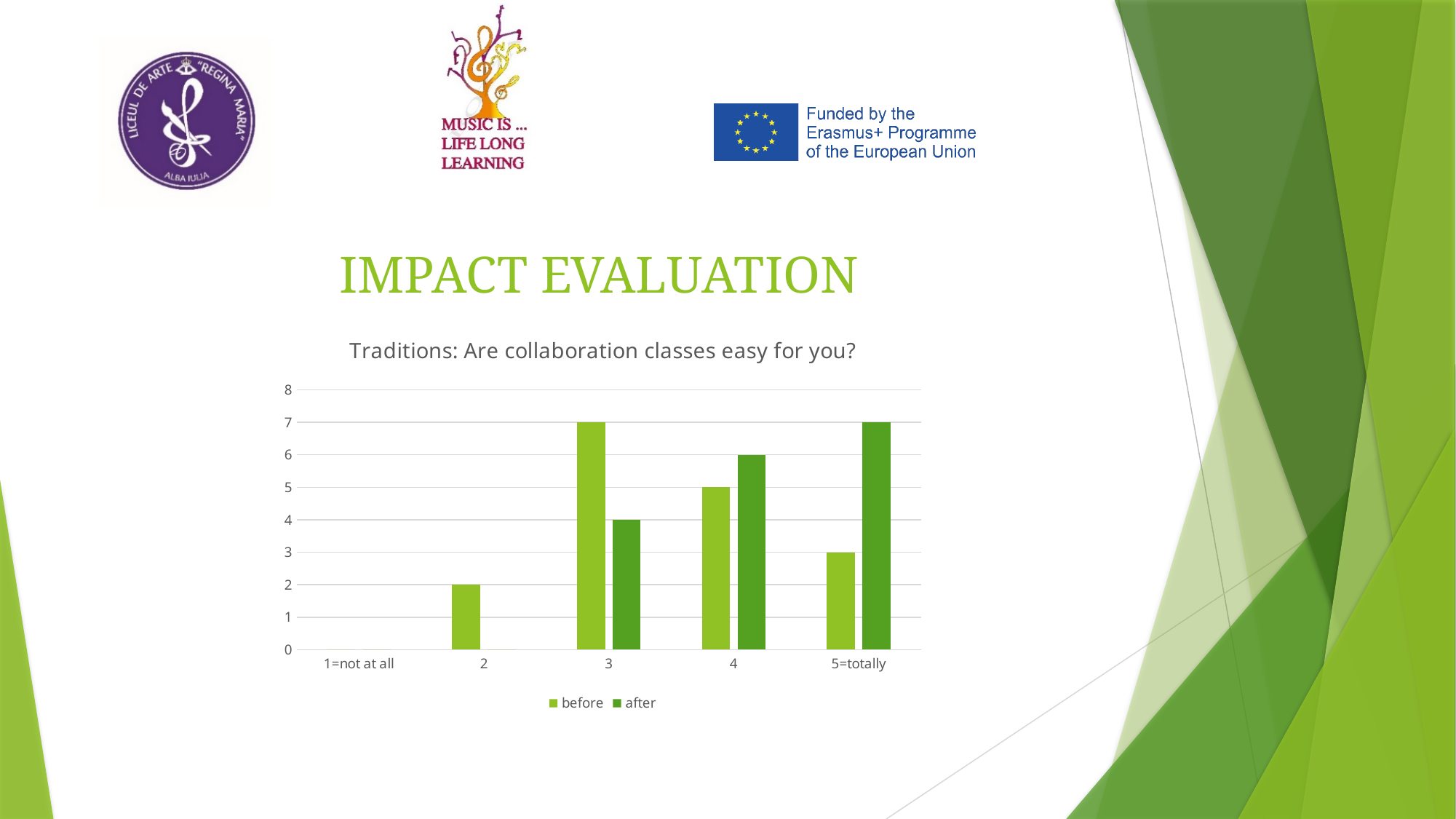
Which category has the highest 'after' value? 5=totally How many series does the legend list? 2 Which category has the highest 'before' value? 3 At category 4, which is larger, the 'before' value or the 'after' value? after What kind of chart is shown on the slide? bar chart How many categories are shown on the x axis? 5 What is the value for 'after' at category 5=totally? 7 What is the difference between the 'before' and 'after' values at category 3? 3 What is the value for 'before' at category 3? 7 What is the value for 'after' at category 4? 6 What is the value for 'before' at category 2? 2 What is the title of the chart? Traditions: Are collaboration classes easy for you?